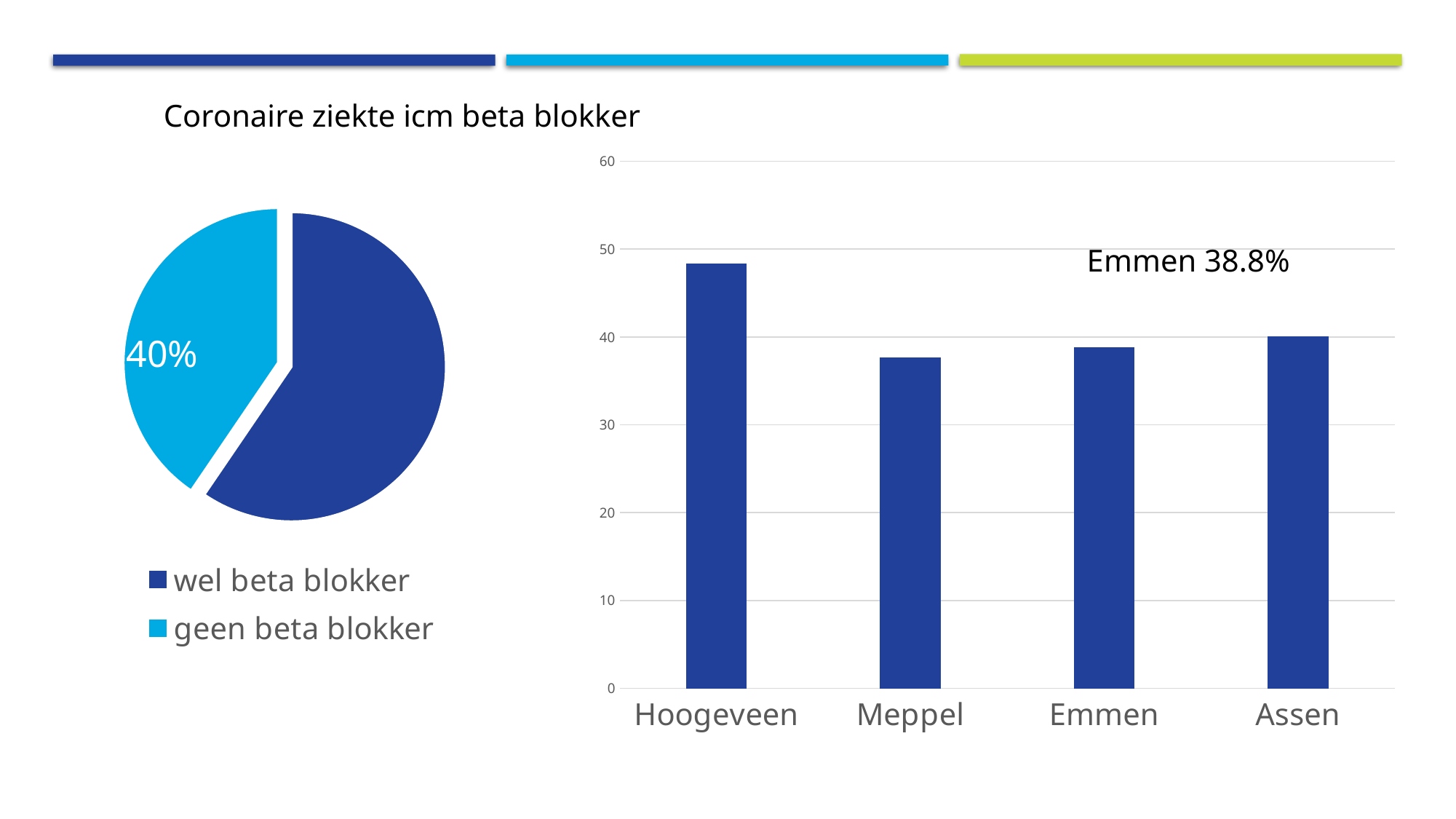
In the pie chart, what share is labelled for the 'geen beta blokker' slice? 40% What kind of chart is on the left side of the slide? pie chart In the bar chart, which category has the highest bar? Hoogeveen In the pie chart, which slice is larger, 'wel beta blokker' or 'geen beta blokker'? wel beta blokker What is the title shown above the charts on the slide? Coronaire ziekte icm beta blokker In the bar chart, is the value for Hoogeveen greater or less than 40? greater How many entries does the legend of the pie chart list? 2 How many categories are shown on the x axis of the bar chart? 4 In the bar chart, which is larger, the value for Hoogeveen or the value for Assen? Hoogeveen In the bar chart, is the value for Meppel greater or less than 40? less What kind of chart is on the right side of the slide? bar chart